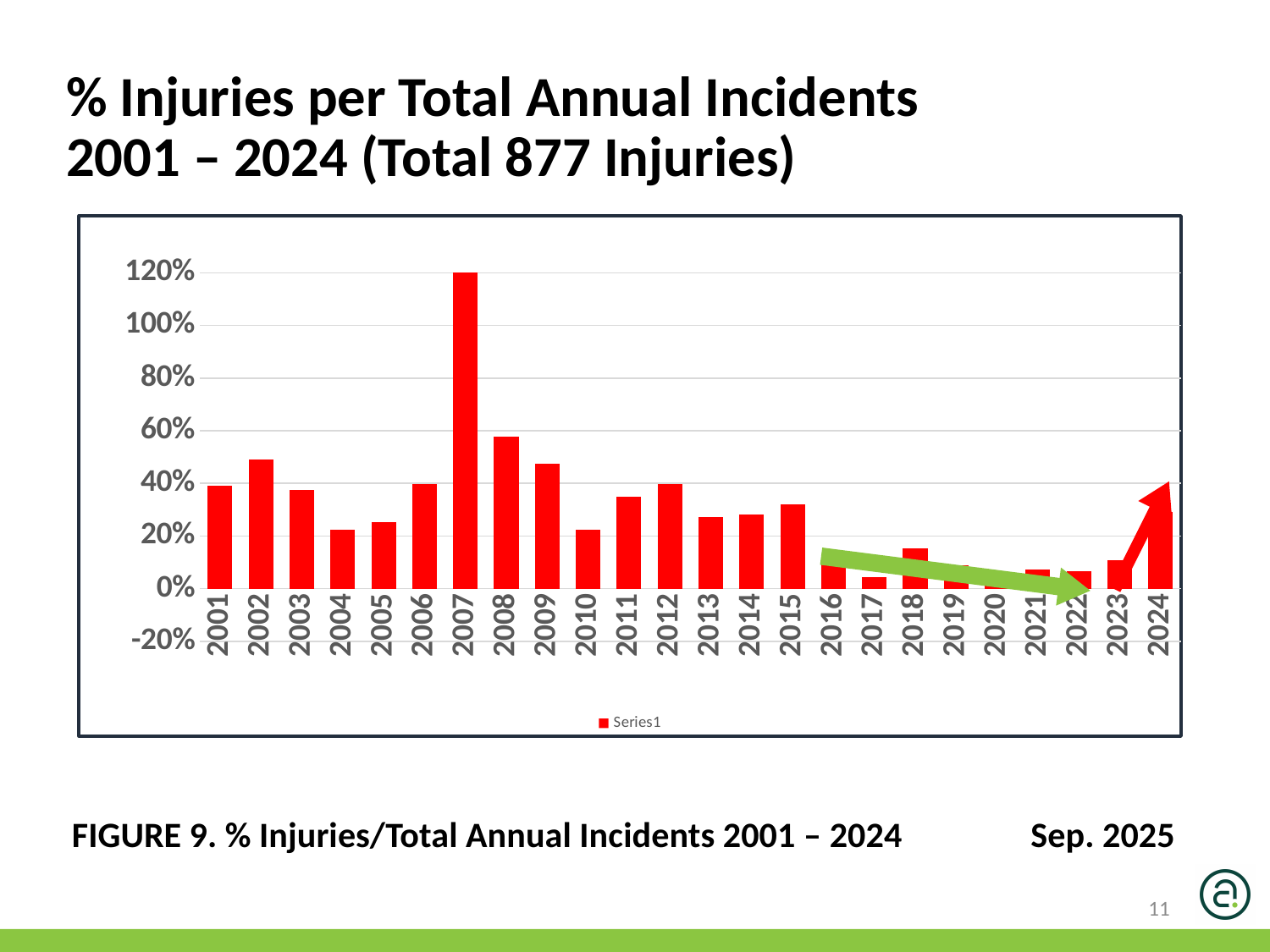
Which year has the larger value, 2008 or 2009? 2008 How many series does the legend list? 1 What kind of chart is shown on the slide? bar chart How many years (bars) are plotted on the chart? 24 Is the value for 2010 greater or less than 40%? less Which year has the larger value, 2002 or 2003? 2002 Which year has the highest % injuries per total annual incidents? 2007 Is the value for 2024 greater or less than 20%? greater Do the values generally rise or fall from 2012 to 2017? fall What is the name of the series shown in the legend? Series1 Is the value for 2002 greater or less than 40%? greater